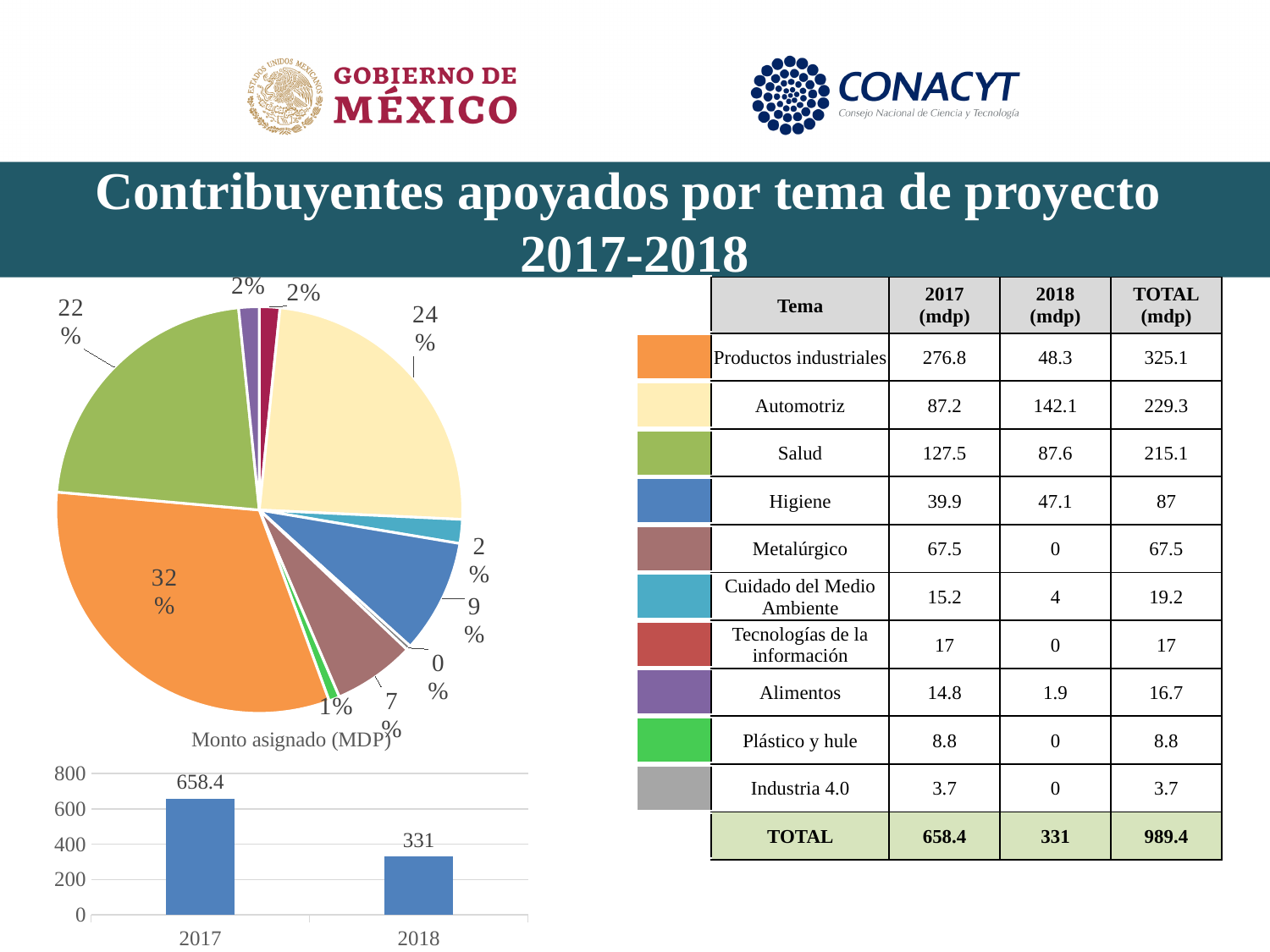
In the bar chart titled "Monto asignado (MDP)", which year has the lower value? 2018 In the bar chart titled "Monto asignado (MDP)", what is the value for 2017? 658.4 What kind of chart is the one at the top left of the slide? pie chart In the pie chart on the left of the slide, what percentage is shown for the pale yellow slice? 24% In the bar chart titled "Monto asignado (MDP)", what is the value for 2018? 331 In the bar chart titled "Monto asignado (MDP)", is the value for 2018 greater or less than 400? less In the bar chart titled "Monto asignado (MDP)", what is the difference between the 2017 and 2018 values? 327.4 In the bar chart titled "Monto asignado (MDP)", which year has the higher value? 2017 In the bar chart titled "Monto asignado (MDP)", how many bars are plotted? 2 What kind of chart is the one titled "Monto asignado (MDP)" at the bottom left of the slide? bar chart In the bar chart titled "Monto asignado (MDP)", do the values rise or fall from 2017 to 2018? fall In the pie chart on the left of the slide, what percentage is shown for the largest slice? 32%